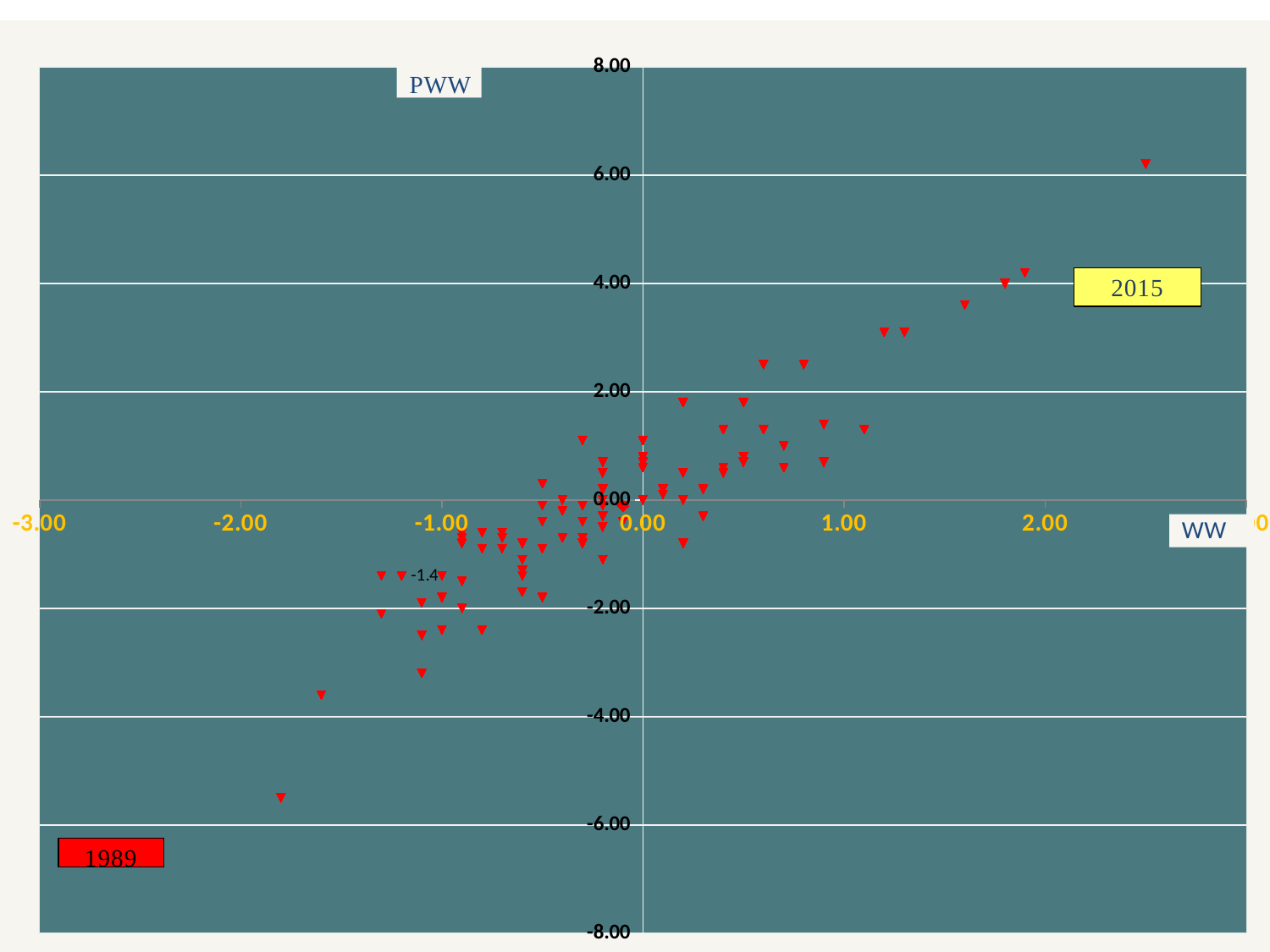
Is the PWW value of the lowest point on the chart greater or less than -4.00? less Is the WW value of the lowest point on the chart greater or less than -1.00? less Which two years are labelled on the chart? 1989 and 2015 What kind of chart is shown on the slide? scatter chart What are the labels of the horizontal and vertical axes of the chart? WW (horizontal) and PWW (vertical) As WW increases along the x axis, do the PWW values generally rise or fall? rise Is the PWW value of the highest point on the chart greater or less than 4.00? greater What value is printed as a data label next to one of the points on the chart? -1.4